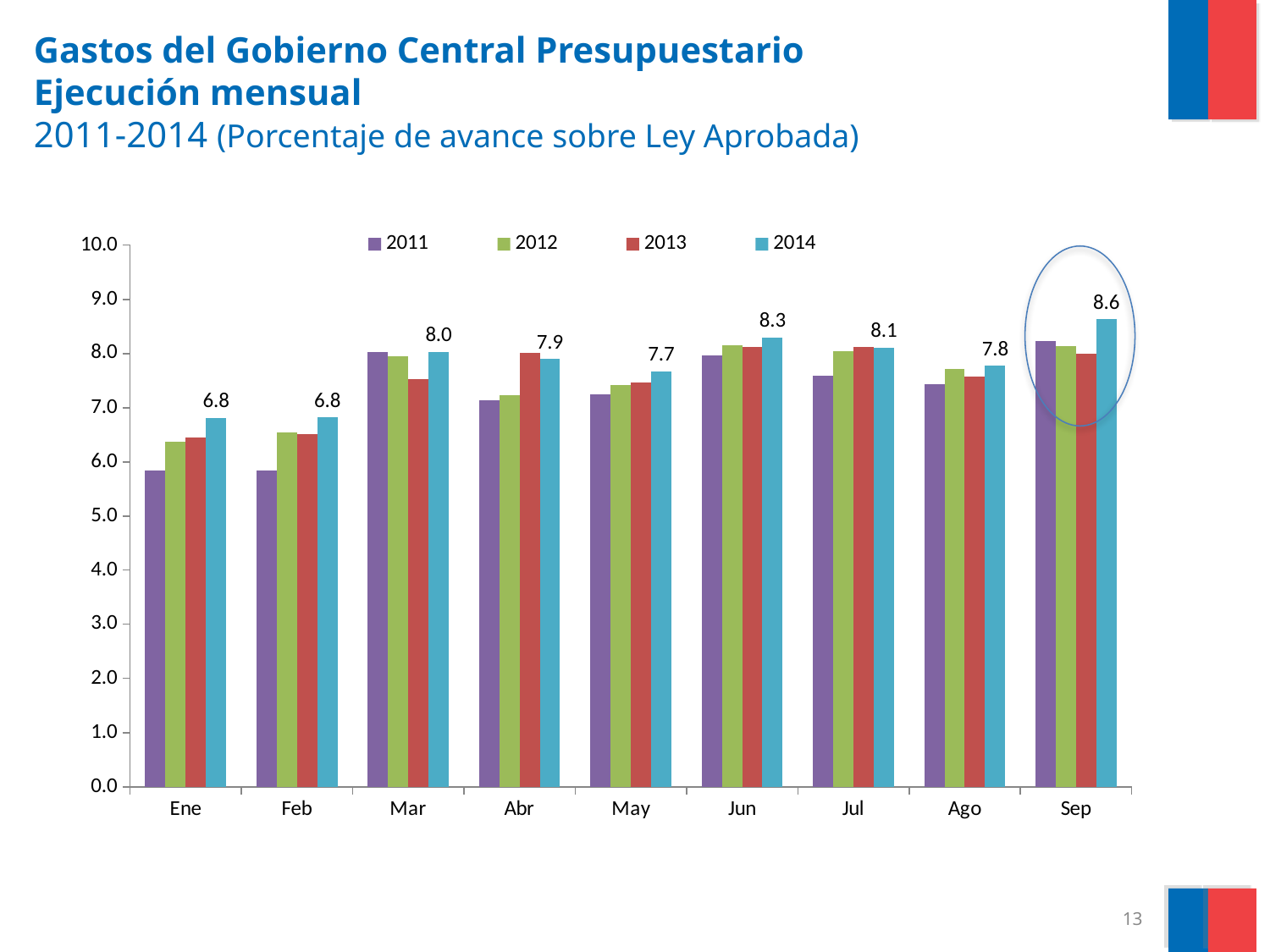
In which month is the 2014 value highest? Sep What is the value for 2014 in Sep? 8.6 Is the value for 2011 in Ene greater or less than 6.0? less What kind of chart is shown on the slide? bar chart How many months are shown on the x axis? 9 Which series has its values printed as data labels above the bars? 2014 What is the difference between the 2014 values for Sep and Ene? 1.8 What is the value for 2014 in Abr? 7.9 What is the value for 2014 in Jun? 8.3 How many series does the legend list? 4 Which is larger, the 2014 value for Jun or the 2014 value for Jul? Jun Is the value for 2013 in Abr greater or less than 7.0? greater